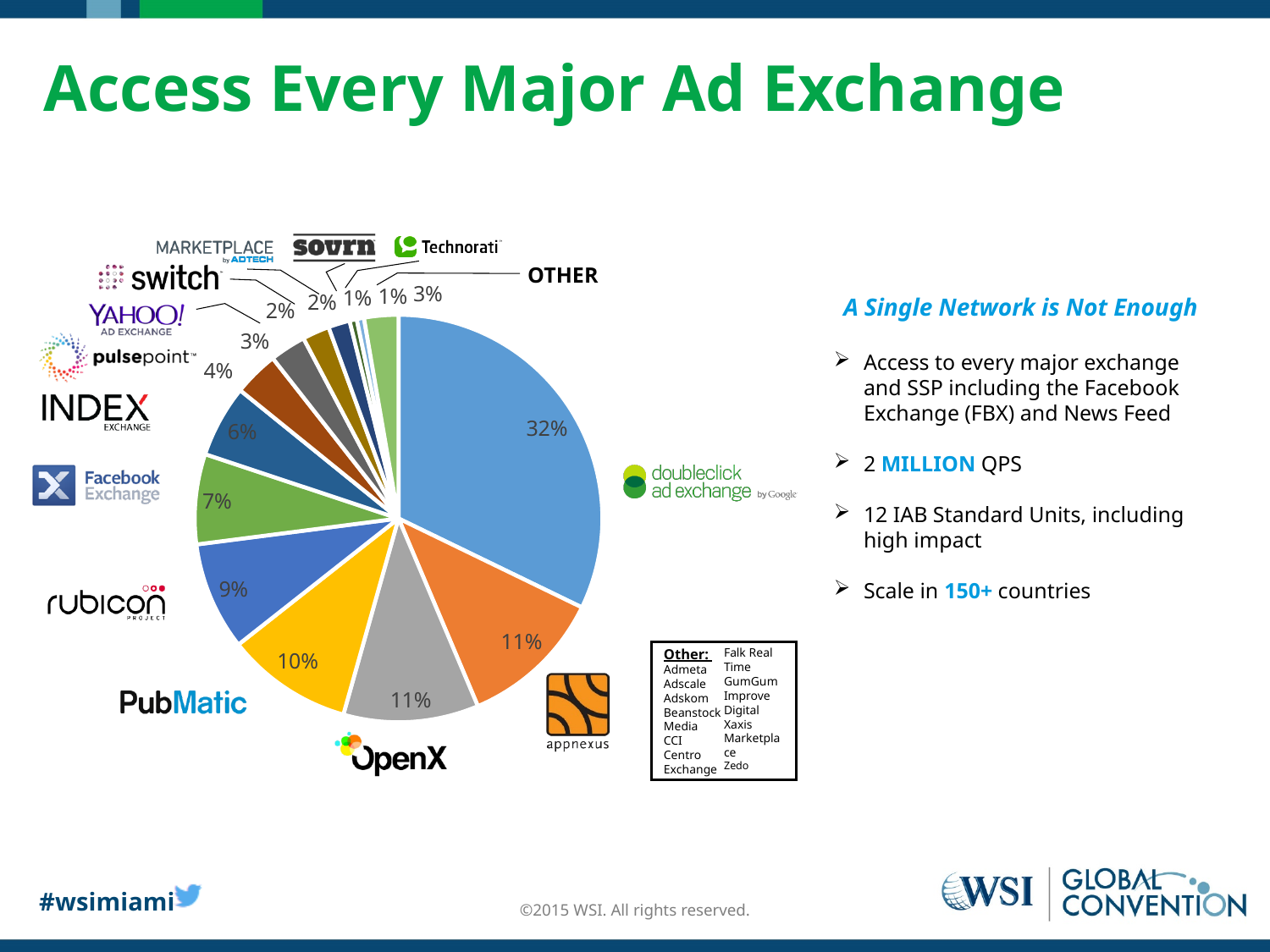
What share of the pie does DoubleClick Ad Exchange hold? 32% What share of the pie is labelled OTHER? 3% What percentage is shown for Index Exchange? 6% What is the difference in percentage points between Facebook Exchange and Index Exchange? 1 What percentage is shown for Rubicon Project? 9% What percentage is shown for PubMatic? 10% What is the difference in percentage points between DoubleClick Ad Exchange and AppNexus? 21 What is the title of the slide containing the pie chart? Access Every Major Ad Exchange What kind of chart is shown on the slide? pie chart Which has a larger share, PubMatic or Rubicon Project? PubMatic Which exchange has the largest slice of the pie? DoubleClick Ad Exchange What percentage is shown for Facebook Exchange? 7%